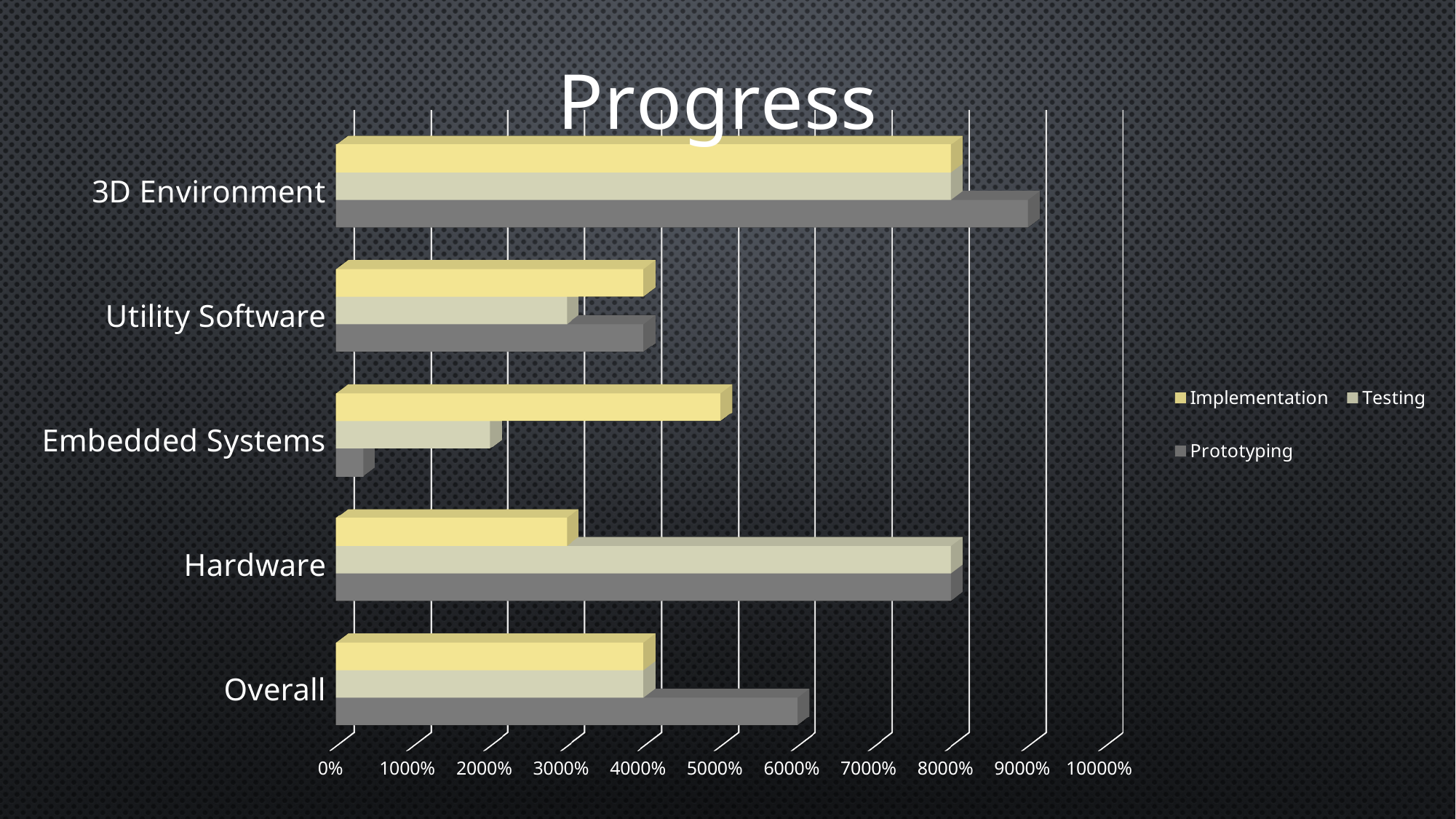
How many series does the legend list? 3 Which category has the lowest Prototyping value? Embedded Systems Is the Testing value for Hardware greater or less than 7000%? greater Is the Implementation value for Hardware greater or less than 4000%? less Which category has the lowest Testing value? Embedded Systems Which category has the highest Prototyping value? 3D Environment What is the title of the chart? Progress For Embedded Systems, which is larger, the Implementation value or the Testing value? Implementation What kind of chart is shown on the slide? bar chart How many categories are shown on the chart? 5 Which category has the highest Implementation value? 3D Environment For Overall, which is larger, the Prototyping value or the Implementation value? Prototyping